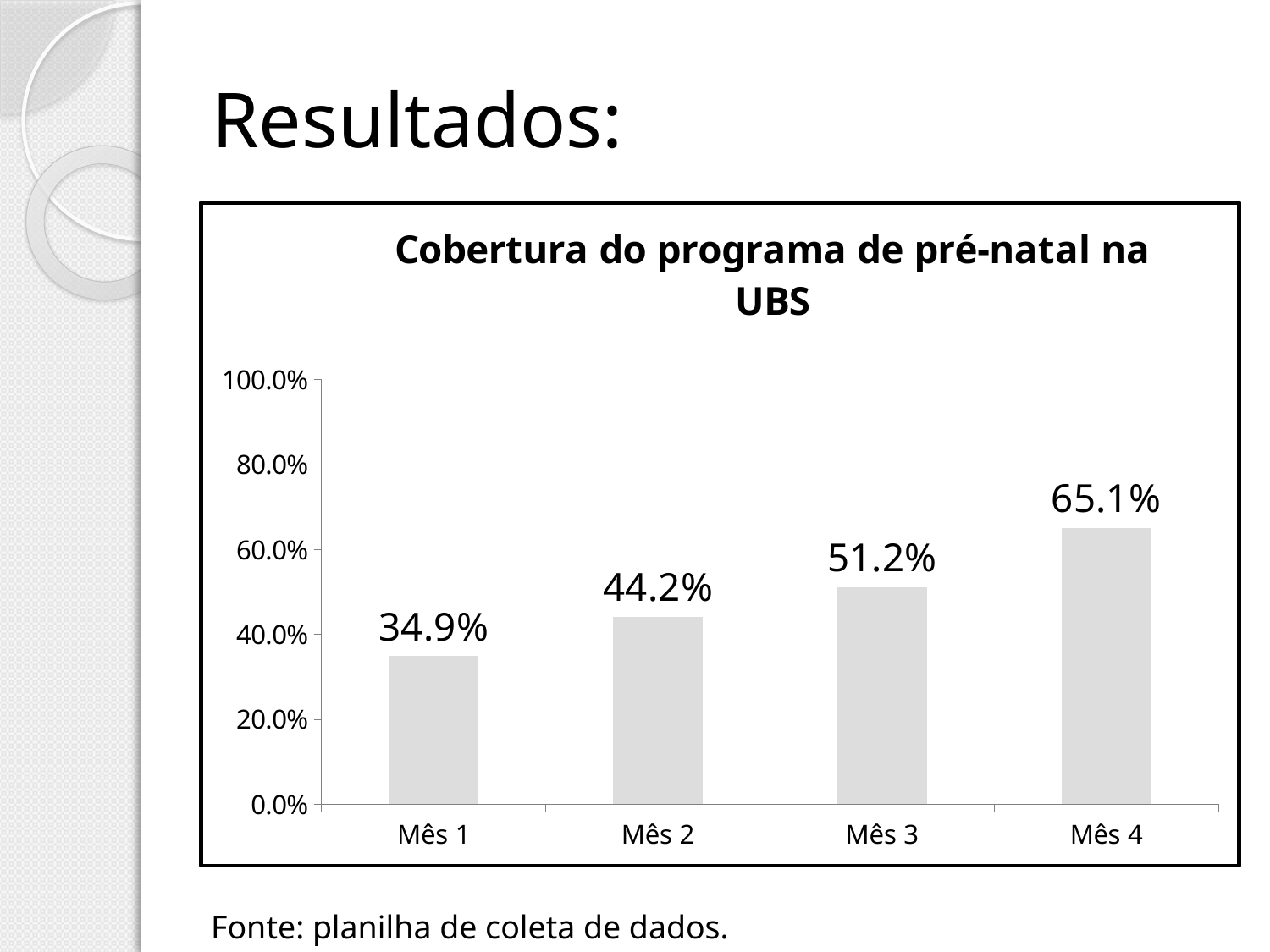
Which month has the lowest coverage? Mês 1 What is the value for Mês 1? 34.9% How many months are shown on the x axis? 4 What is the value for Mês 3? 51.2% What is the difference between the values for Mês 2 and Mês 1? 9.3% What is the value for Mês 4? 65.1% Is the value for Mês 4 greater or less than 60.0%? greater Do the values rise or fall from Mês 1 to Mês 4? rise What is the difference between the values for Mês 4 and Mês 1? 30.2% What kind of chart is shown on the slide? bar chart Which is larger, the value for Mês 2 or the value for Mês 3? Mês 3 Which month has the highest coverage? Mês 4